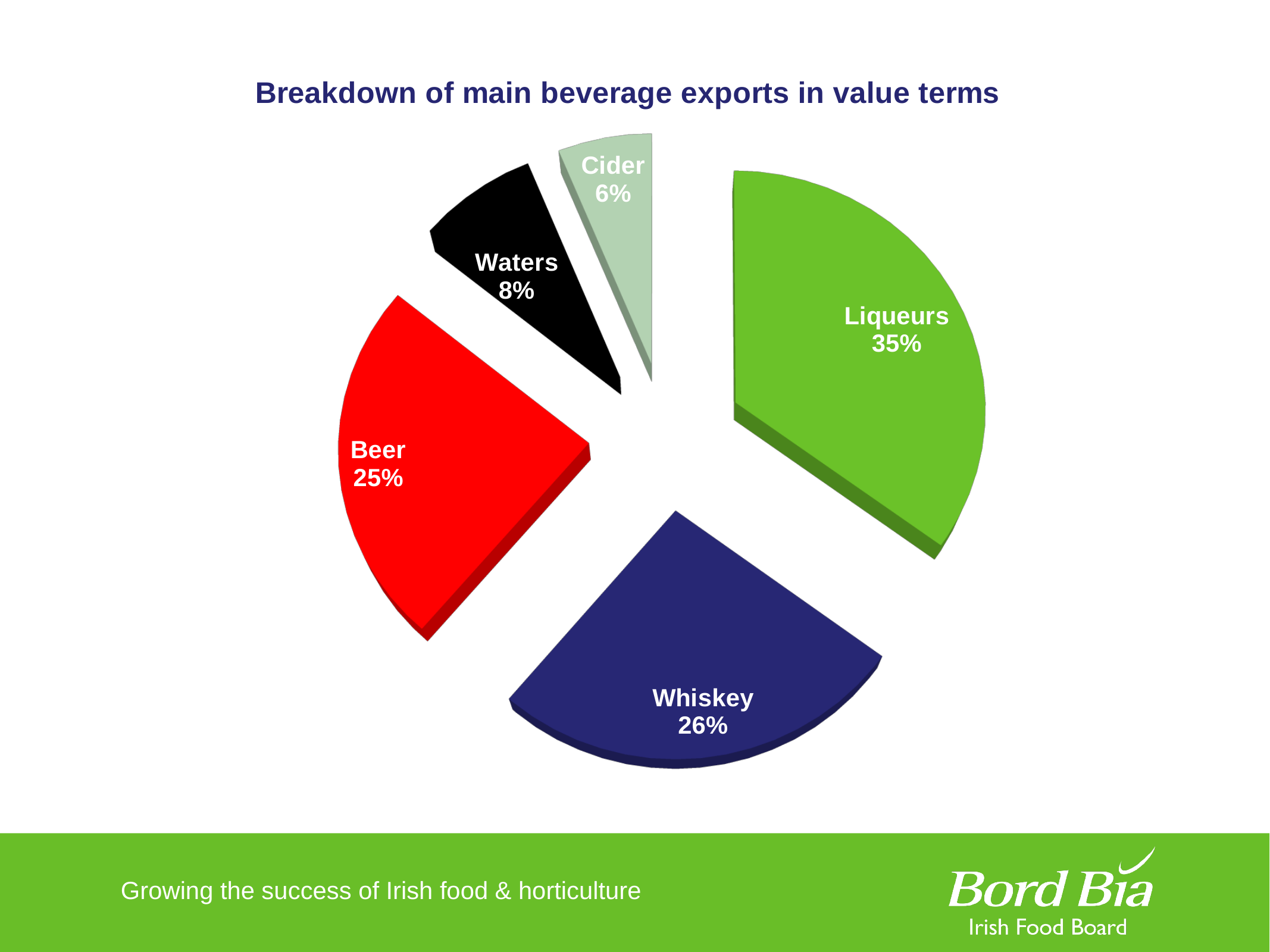
What kind of chart is shown on the slide? Pie chart Which beverage category has the smallest share of exports in value terms? Cider What is the difference in percentage points between the Liqueurs share and the Beer share? 10 How many beverage categories are shown in the pie chart? 5 What share of main beverage exports in value terms is Whiskey? 26% What share of main beverage exports in value terms is Waters? 8% Which has a larger share of beverage exports, Waters or Cider? Waters What share of main beverage exports in value terms is Beer? 25% Which beverage category has the largest share of exports in value terms? Liqueurs What share of main beverage exports in value terms is Cider? 6% What share of main beverage exports in value terms is Liqueurs? 35% What colour is the Whiskey slice in the pie chart? Dark blue